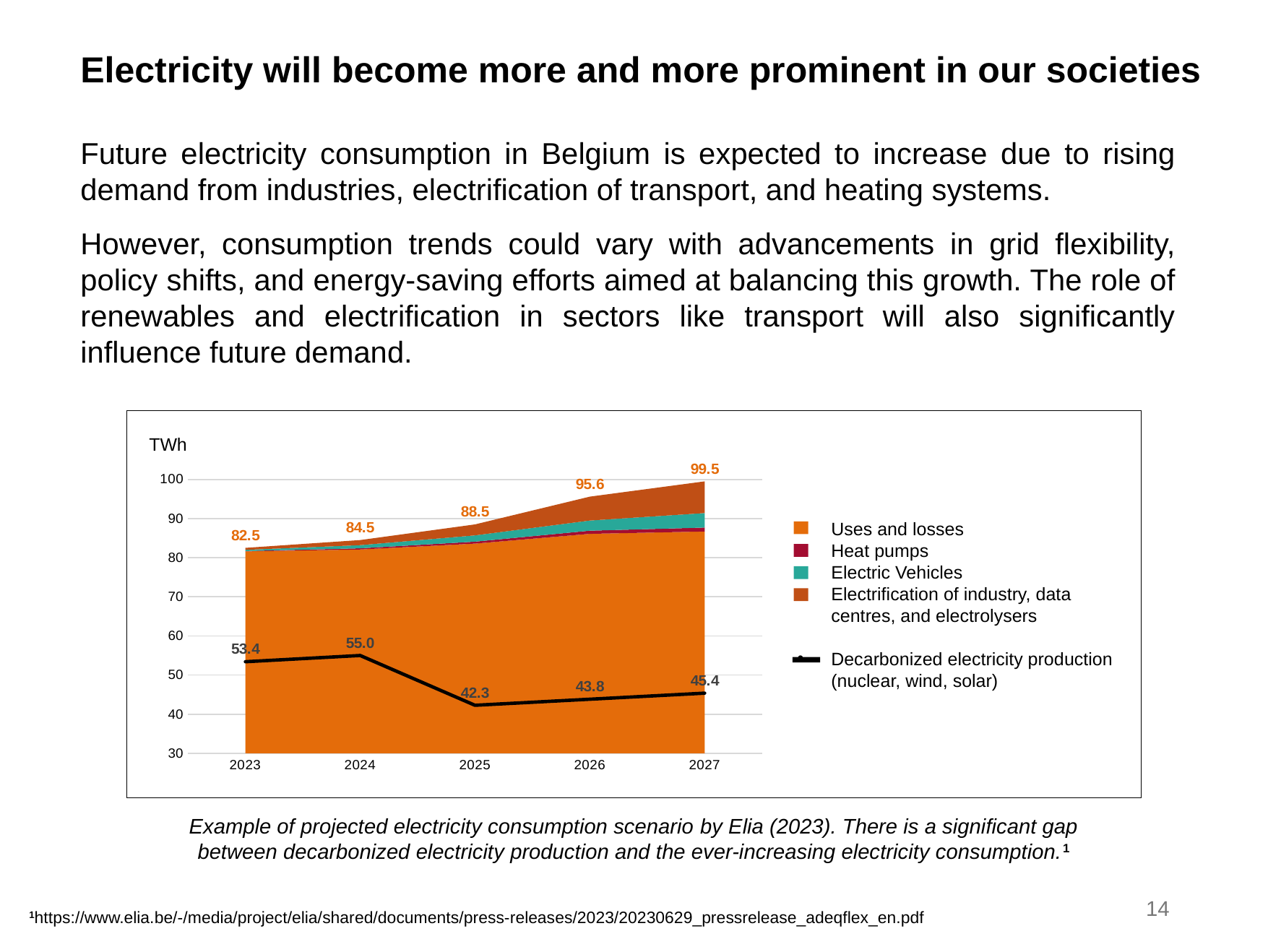
What unit is shown on the y axis of the chart? TWh What is the total electricity consumption value shown for 2023? 82.5 What is the total electricity consumption value shown for 2027? 99.5 How many entries does the legend list? 5 What is the difference between total consumption in 2027 and in 2023? 17.0 In which year is decarbonized electricity production lowest? 2025 What is the difference between decarbonized electricity production in 2024 and in 2025? 12.7 Which is larger: total consumption in 2026 or decarbonized production in 2026? Total consumption in 2026 How many years are shown on the x axis? 5 What is the decarbonized electricity production value shown for 2025? 42.3 Does total electricity consumption rise or fall from 2023 to 2027? Rise In which year is decarbonized electricity production highest? 2024